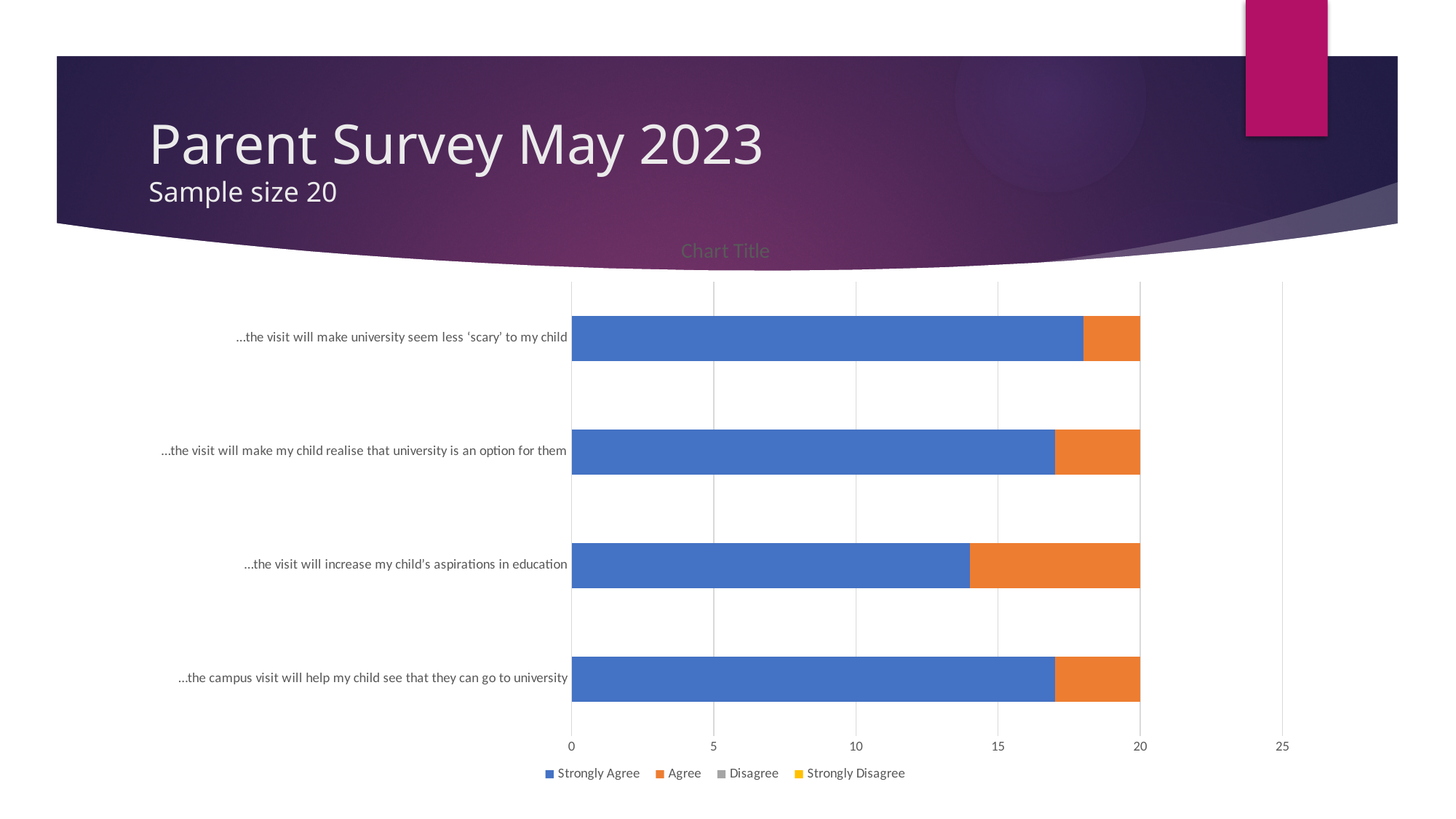
How many series does the chart legend list? 4 What is the total length of the bar for '...the campus visit will help my child see that they can go to university'? 20 Which statement has the lowest 'Strongly Agree' value? ...the visit will increase my child's aspirations in education Is the 'Strongly Agree' value for '...the visit will increase my child's aspirations in education' greater or less than 15? less Which statement has the highest 'Strongly Agree' value? ...the visit will make university seem less 'scary' to my child Which colour represents the 'Agree' series in the chart? Orange How many categories (survey statements) are plotted on the chart? 4 Which is larger: the 'Strongly Agree' value for '...the visit will make university seem less 'scary' to my child' or for '...the visit will increase my child's aspirations in education'? ...the visit will make university seem less 'scary' to my child Is the 'Strongly Agree' value for '...the visit will make university seem less 'scary' to my child' greater or less than 15? greater What is the total length of the bar for '...the visit will increase my child's aspirations in education'? 20 What kind of chart is shown on the slide? Stacked bar chart Which statement has the highest 'Agree' value? ...the visit will increase my child's aspirations in education